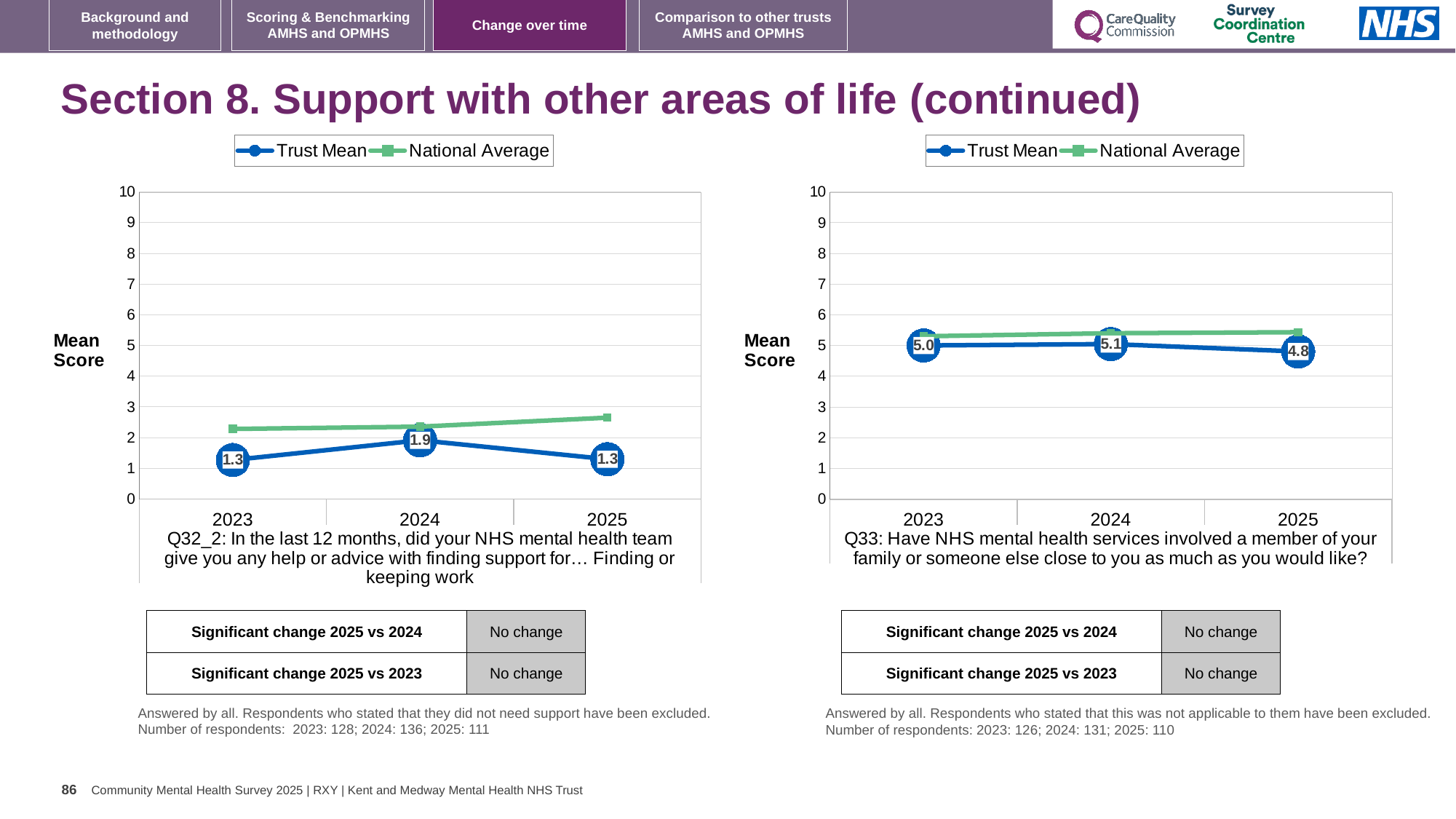
In the left chart (Q32_2), in which year is the Trust Mean highest? 2024 In the left chart (Q32_2), what is the difference between the Trust Mean in 2024 and in 2023? 0.6 In the left chart (Q32_2), what is the Trust Mean value for 2024? 1.9 In the right chart (Q33), which series has the higher value in 2025, Trust Mean or National Average? National Average In the right chart (Q33), in which year is the Trust Mean lowest? 2025 In the right chart (Q33), how many series does the legend list? 2 In the right chart (Q33), what is the difference between the Trust Mean in 2024 and in 2025? 0.3 In the left chart (Q32_2), how many years are plotted on the x axis? 3 In the right chart (Q33), what is the Trust Mean value for 2025? 4.8 In the left chart (Q32_2), what kind of chart is shown? line chart In the left chart (Q32_2), is the National Average value for 2025 greater or less than 2? greater In the right chart (Q33), what are the two series named in the legend? Trust Mean and National Average